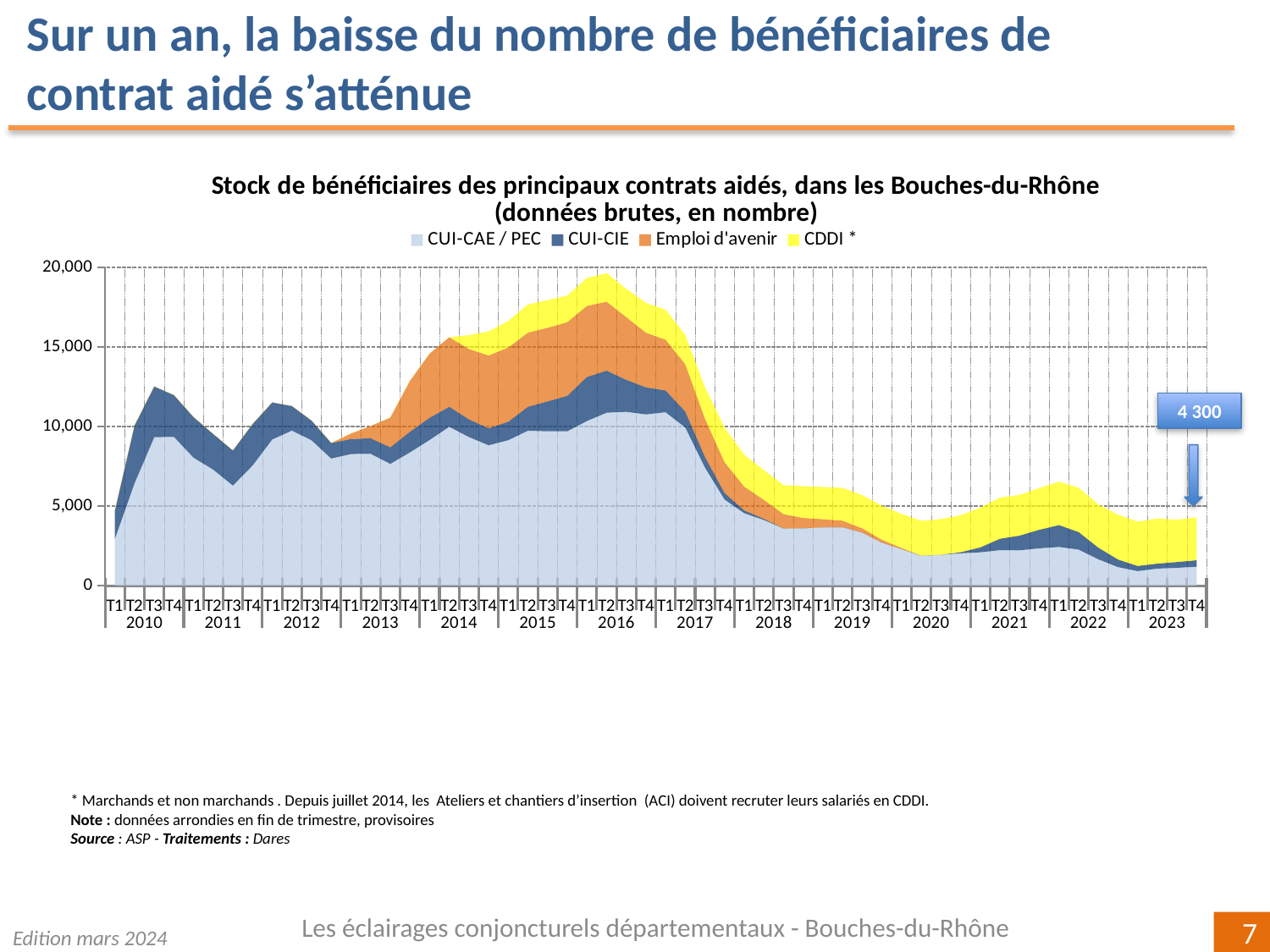
How many years are labelled along the x axis? 14 What value is printed in the callout label at the right of the chart? 4 300 What kind of chart is shown on the slide? Stacked area chart Which series is listed first in the legend? CUI-CAE / PEC Is the total stock in T1 2020 greater or less than 5,000? less Is the total stock in T2 2016 greater or less than 15,000? greater How many series does the legend list? 4 Is the total stock in T4 2023 greater or less than 5,000? less In which year does the total stock reach its highest level? 2016 Which is larger, the total stock in T2 2016 or in T4 2023? T2 2016 Does the total stock rise or fall between 2016 and 2020? Fall